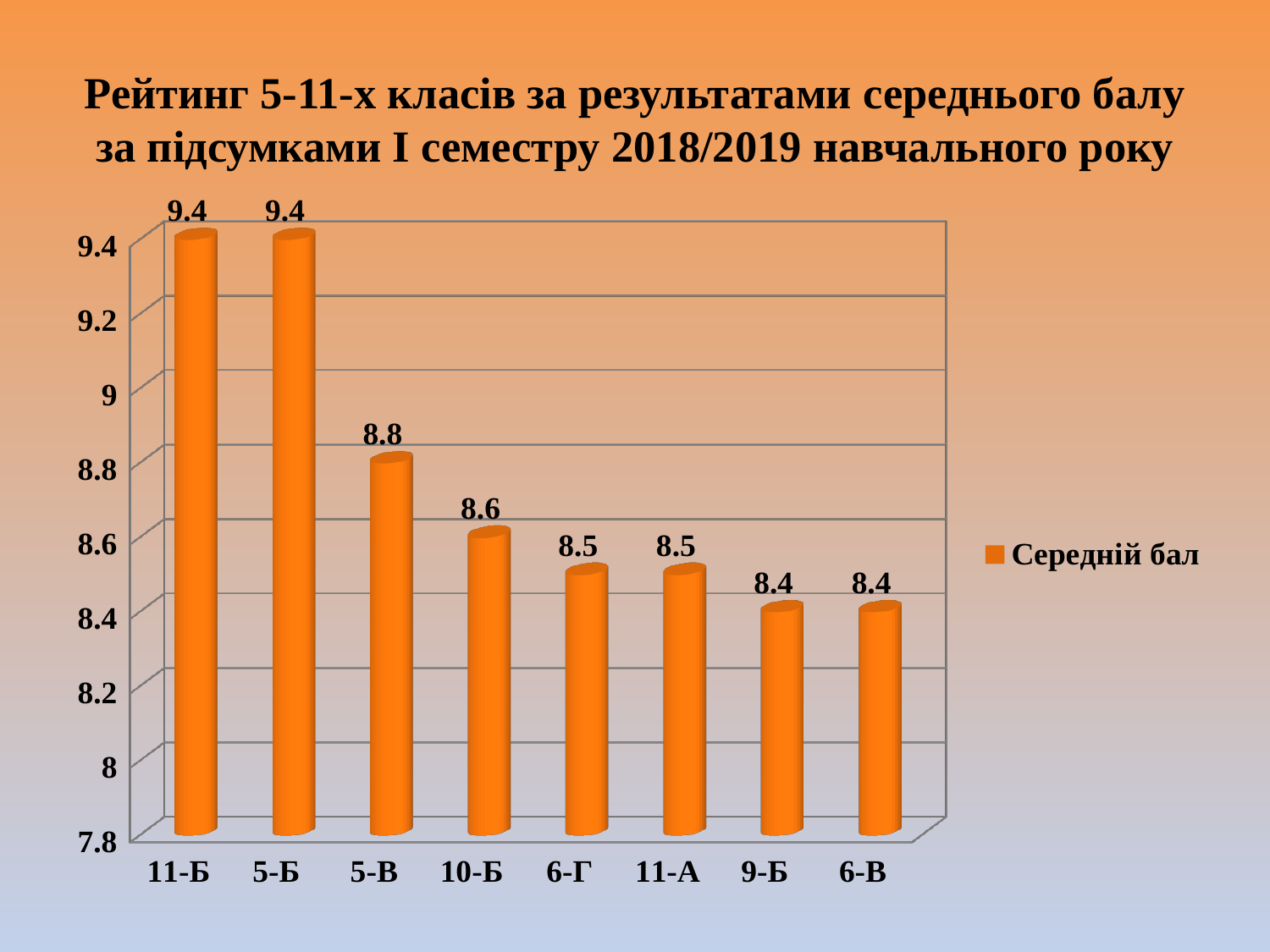
What is the difference between the average score of 11-Б and that of 9-Б? 1 What is the name of the series shown in the legend? Середній бал Which class has a higher average score, 5-В or 6-Г? 5-В Which classes have the highest average score? 11-Б and 5-Б What is the average score for class 6-В? 8.4 Which classes have the lowest average score? 9-Б and 6-В What is the average score (Середній бал) for class 5-В? 8.8 What is the average score for class 11-А? 8.5 What is the difference between the average score of 5-В and that of 10-Б? 0.2 What is the average score for class 10-Б? 8.6 How many classes are shown on the chart? 8 What type of chart is shown on the slide? Bar chart